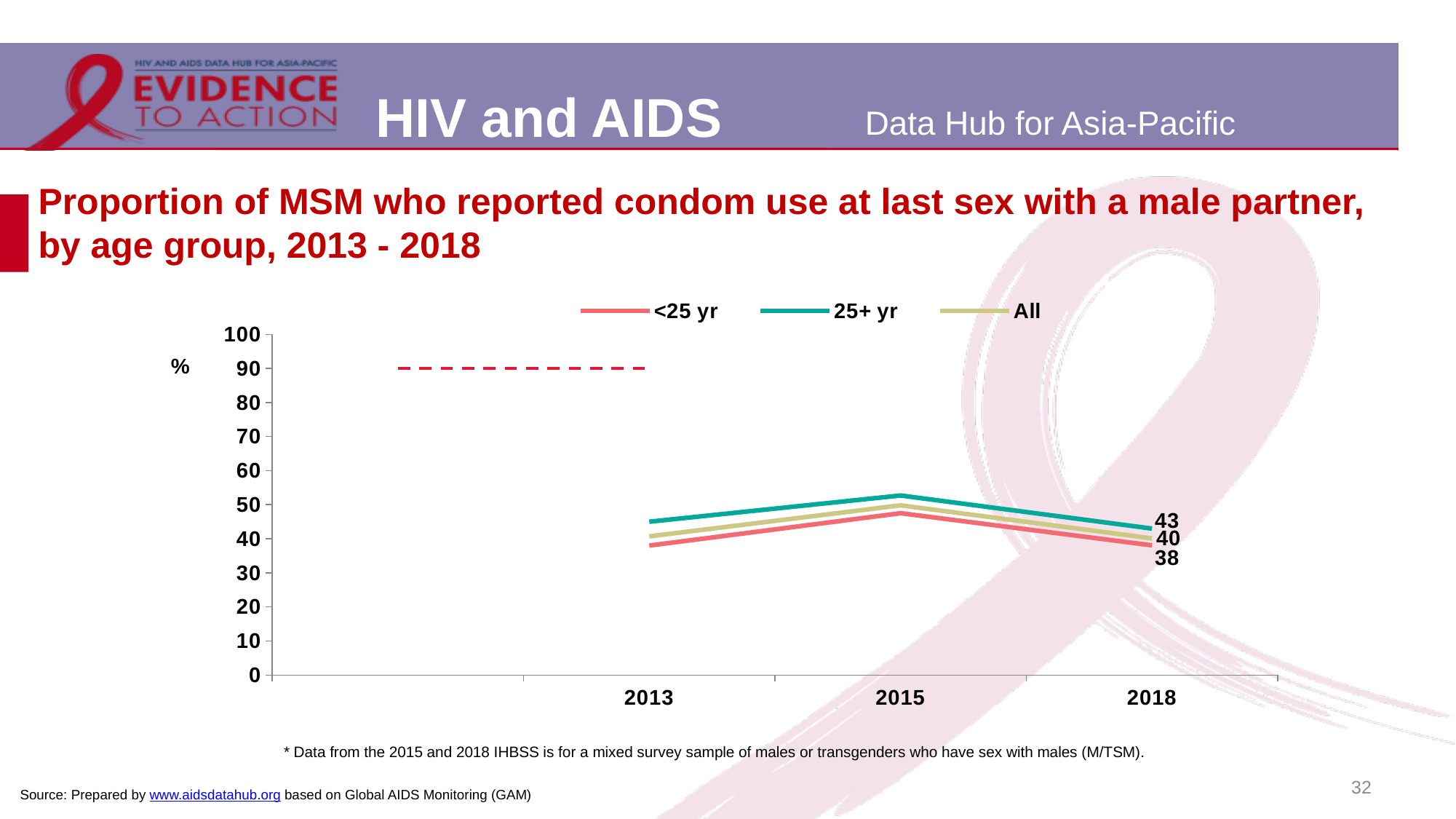
Which series has the lowest value in 2018? <25 yr How many series does the legend list? 3 How many years are shown on the x axis? 3 What is the value for the <25 yr series in 2018? 38 What type of chart is shown on the slide? line chart What is the difference between the 25+ yr and <25 yr values in 2018? 5 Which series has the highest value in 2018? 25+ yr Is the value for the <25 yr series in 2013 greater or less than 40? less What is the value for the 25+ yr series in 2018? 43 Is the value for the 25+ yr series in 2015 greater or less than 50? greater What is the value for the All series in 2018? 40 Does the All series rise or fall from 2015 to 2018? fall